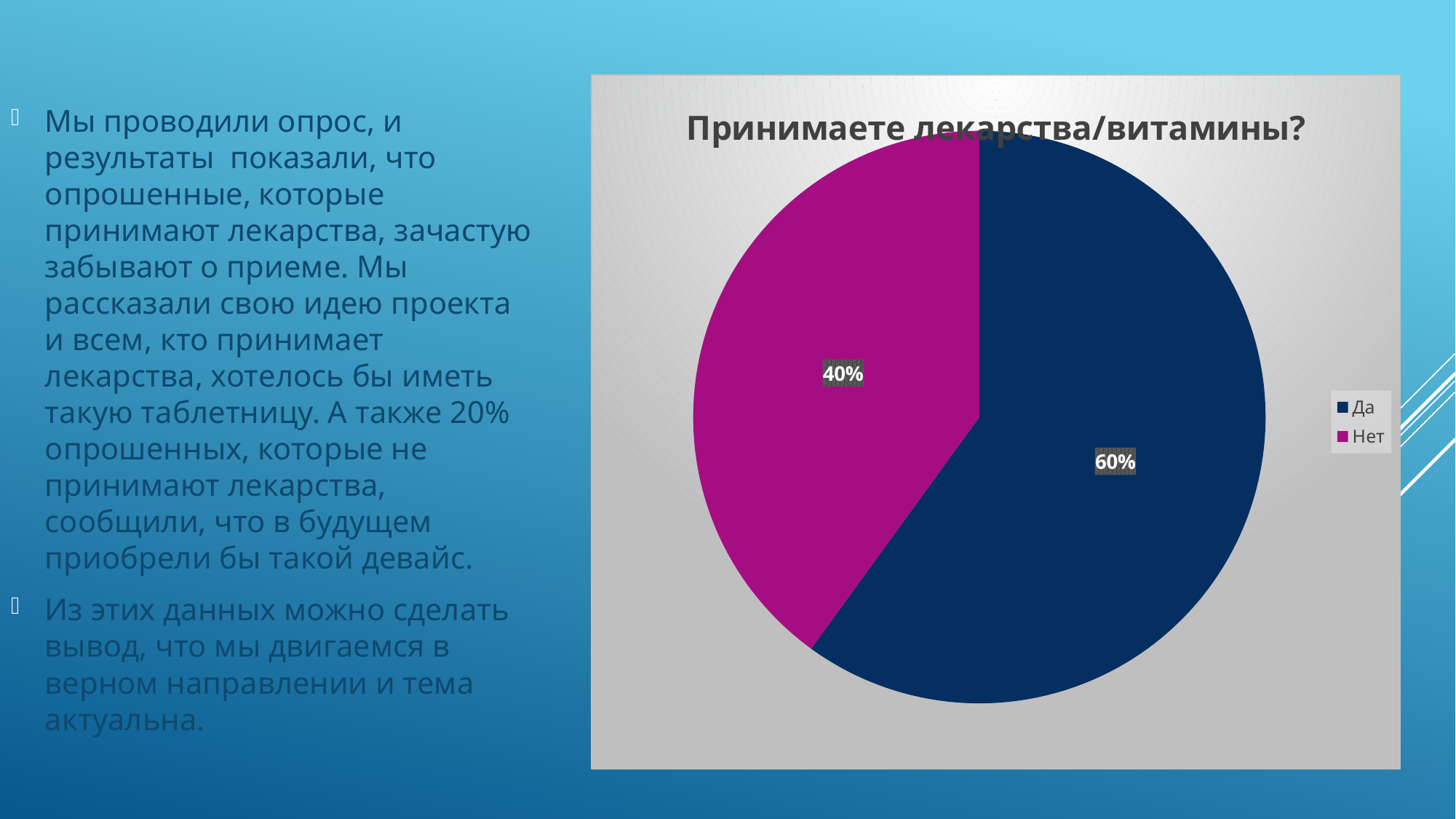
Which slice is larger, "Да" or "Нет"? Да Which category has the smallest slice of the pie? Нет What is the title of the chart? Принимаете лекарства/витамины? What colour is the "Нет" slice? magenta What share of the pie does the "Нет" slice represent? 40% How many categories does the pie chart show? 2 What share of the pie does the "Да" slice represent? 60% Which category has the largest slice of the pie? Да What is the difference in percentage points between the "Да" and "Нет" slices? 20% What type of chart is shown on the slide? pie chart How many entries does the legend list? 2